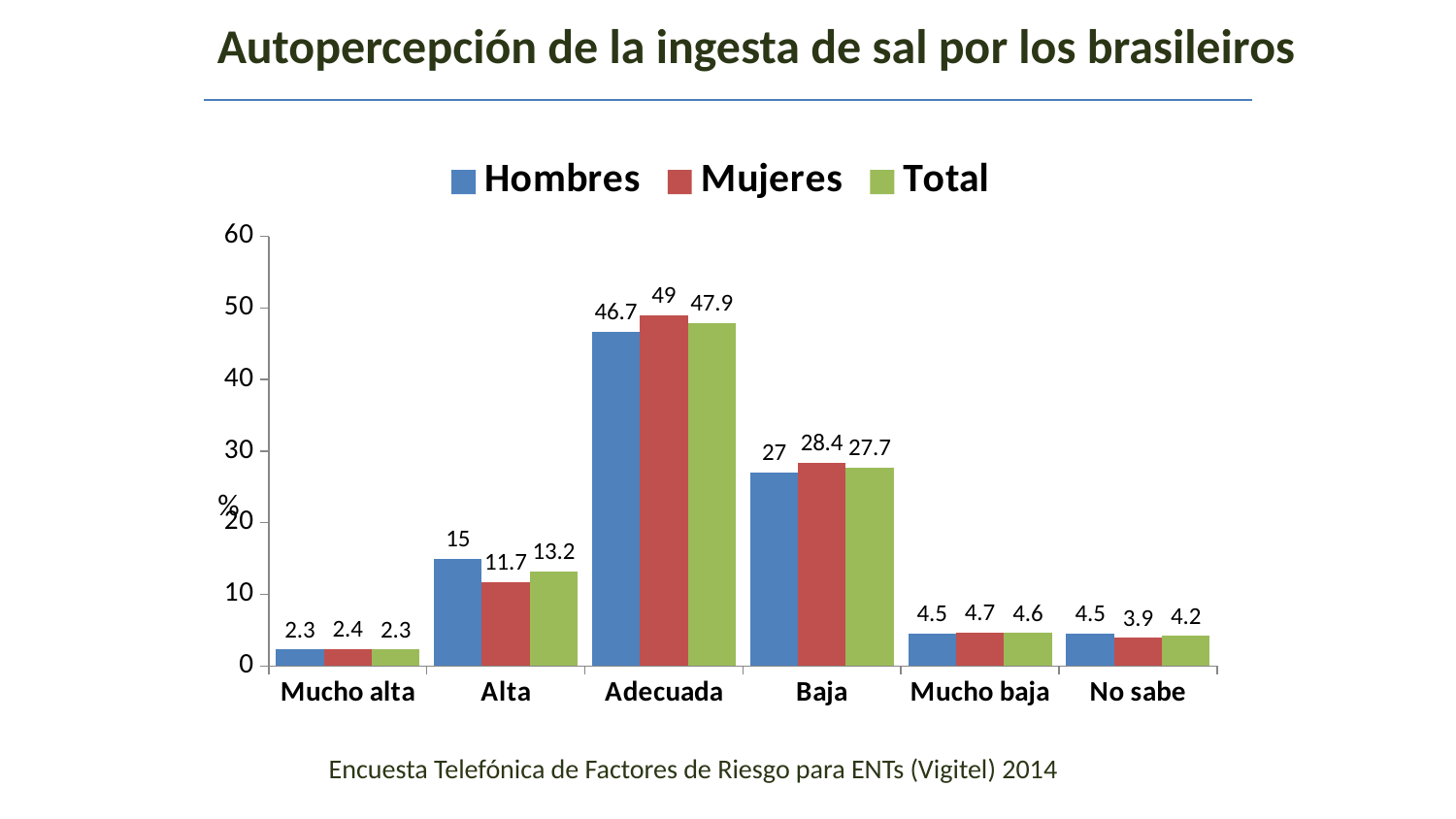
What is the value for Hombres in the Alta category? 15 What is the difference between the Mujeres and Hombres values in the Adecuada category? 2.3 What is the title of the chart? Autopercepción de la ingesta de sal por los brasileiros What is the value for Mujeres in the Adecuada category? 49 Which category has the lowest Hombres value? Mucho alta Which category has the highest Total value? Adecuada Which is larger in the Alta category, the Hombres value or the Mujeres value? Hombres What kind of chart is shown on the slide? Bar chart How many series does the legend list? 3 Is the Total value for Baja greater or less than 20? greater How many categories are shown on the x axis? 6 What is the Total value for the Baja category? 27.7